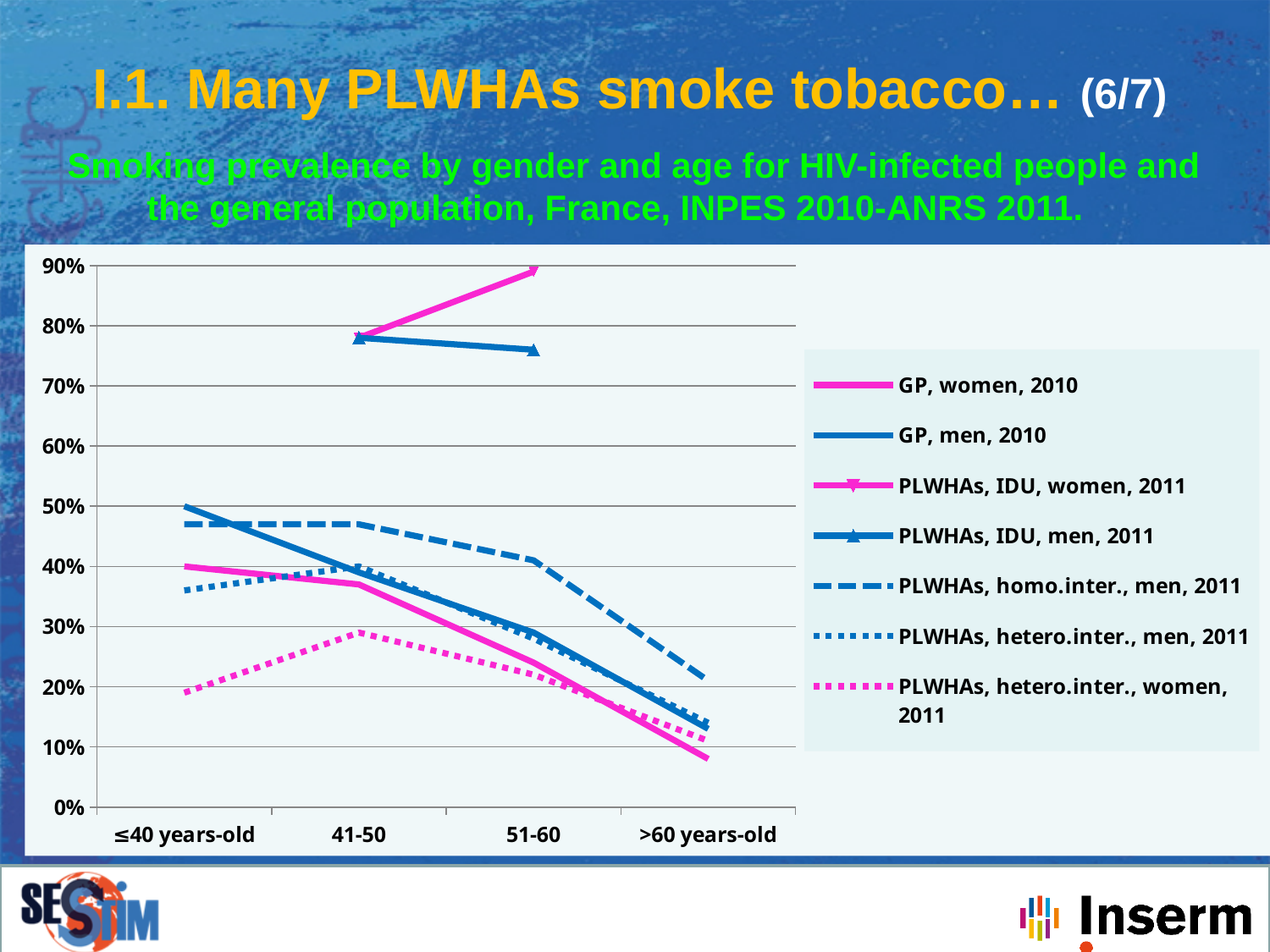
Which series has the lowest value at ≤40 years-old? PLWHAs, hetero.inter., women, 2011 Is the value for PLWHAs, hetero.inter., women, 2011 at ≤40 years-old greater or less than 30%? less Is the value for GP, women, 2010 at ≤40 years-old greater or less than 30%? greater At 51-60, which is higher: PLWHAs, IDU, women, 2011 or PLWHAs, IDU, men, 2011? PLWHAs, IDU, women, 2011 Does the GP, women, 2010 line rise or fall from ≤40 years-old to >60 years-old? fall Is the value for PLWHAs, IDU, men, 2011 at 51-60 greater or less than 80%? less Which series has the highest value at 51-60? PLWHAs, IDU, women, 2011 At >60 years-old, which is higher: PLWHAs, homo.inter., men, 2011 or GP, men, 2010? PLWHAs, homo.inter., men, 2011 How many age categories are shown on the x axis? 4 How many series does the legend list? 7 What kind of chart is shown on the slide? line chart